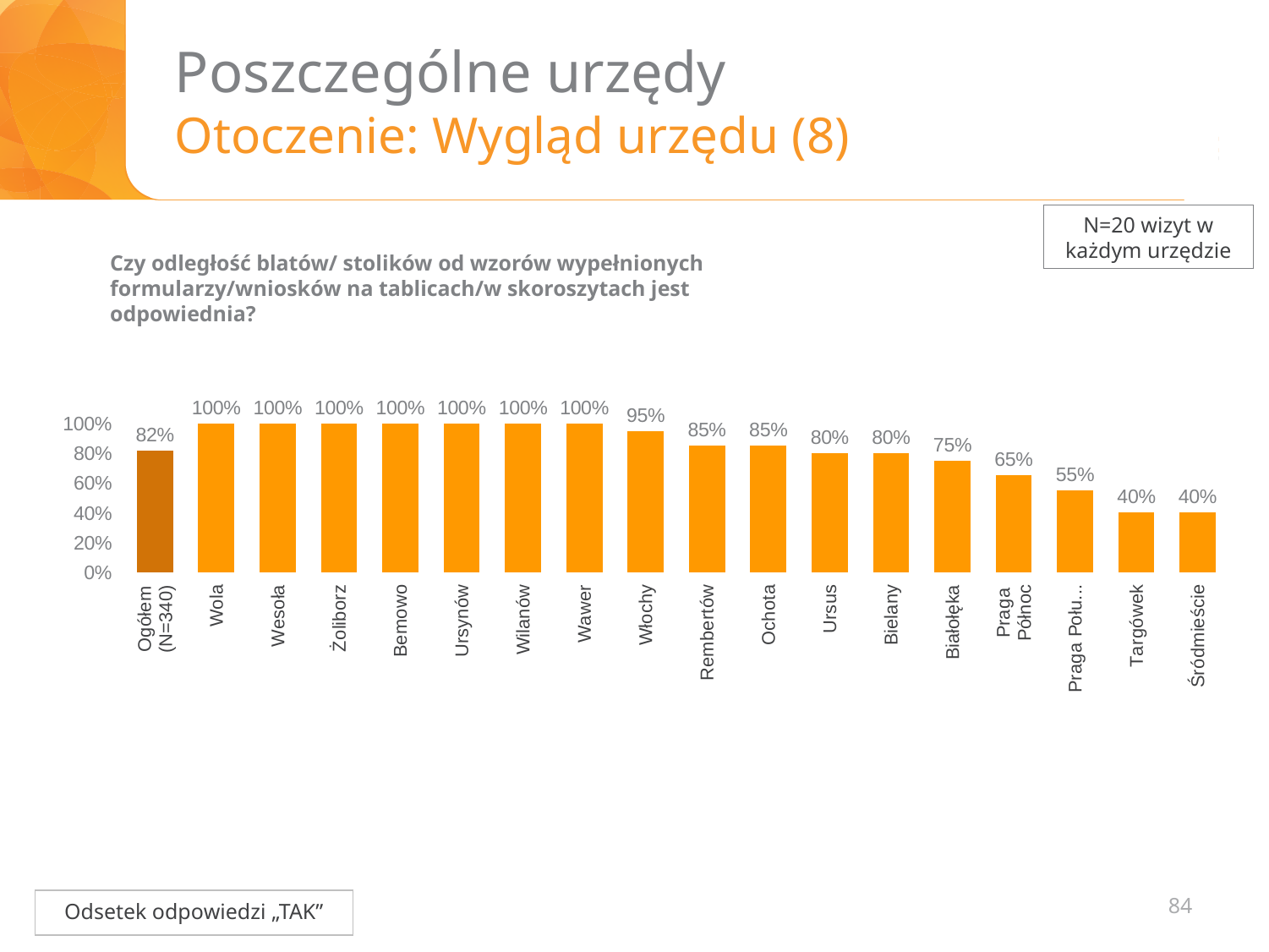
Do the values for the individual offices rise or fall from left to right across the chart? Fall What is the value for Białołęka? 75% What kind of chart is shown on the slide? Bar chart What is the difference between the values for Wola and Śródmieście? 60% What is the value for Ogółem (N=340)? 82% What is the difference between the values for Rembertów and Bielany? 5% Which is larger, the value for Ursus or the value for Białołęka? Ursus What is the value for Praga Północ? 65% Which is larger, the value for Ochota or the value for Praga Północ? Ochota What is the value for Włochy? 95% How many bars are shown in the chart? 18 What is the value for Targówek? 40%